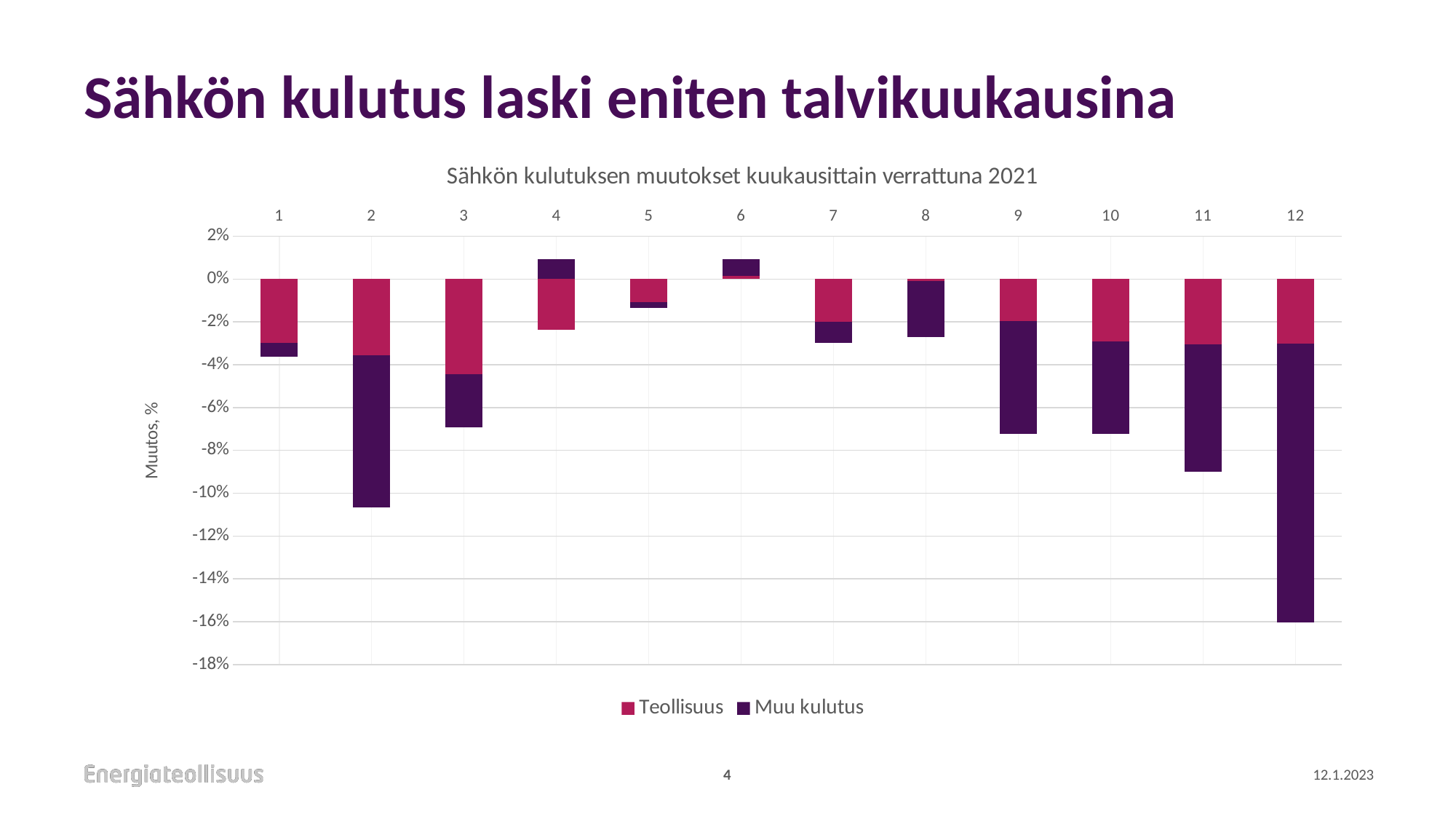
Which month has the larger total decrease, month 9 or month 12? 12 What is the title of the chart? Sähkön kulutuksen muutokset kuukausittain verrattuna 2021 Is the bottom of the stacked bar for month 2 greater or less than -10%? less How many series does the chart's legend list? 2 What kind of chart is shown on the slide? bar chart Is the bottom of the stacked bar for month 1 greater or less than -4%? greater Which month is the only one whose stacked bar is entirely above 0%? 6 Which series is shown in dark purple in the chart? Muu kulutus Is the bottom of the stacked bar for month 3 greater or less than -6%? less How many months (categories) are shown on the x axis of the chart? 12 Which month has the largest total decrease (lowest stacked bar) in the chart? 12